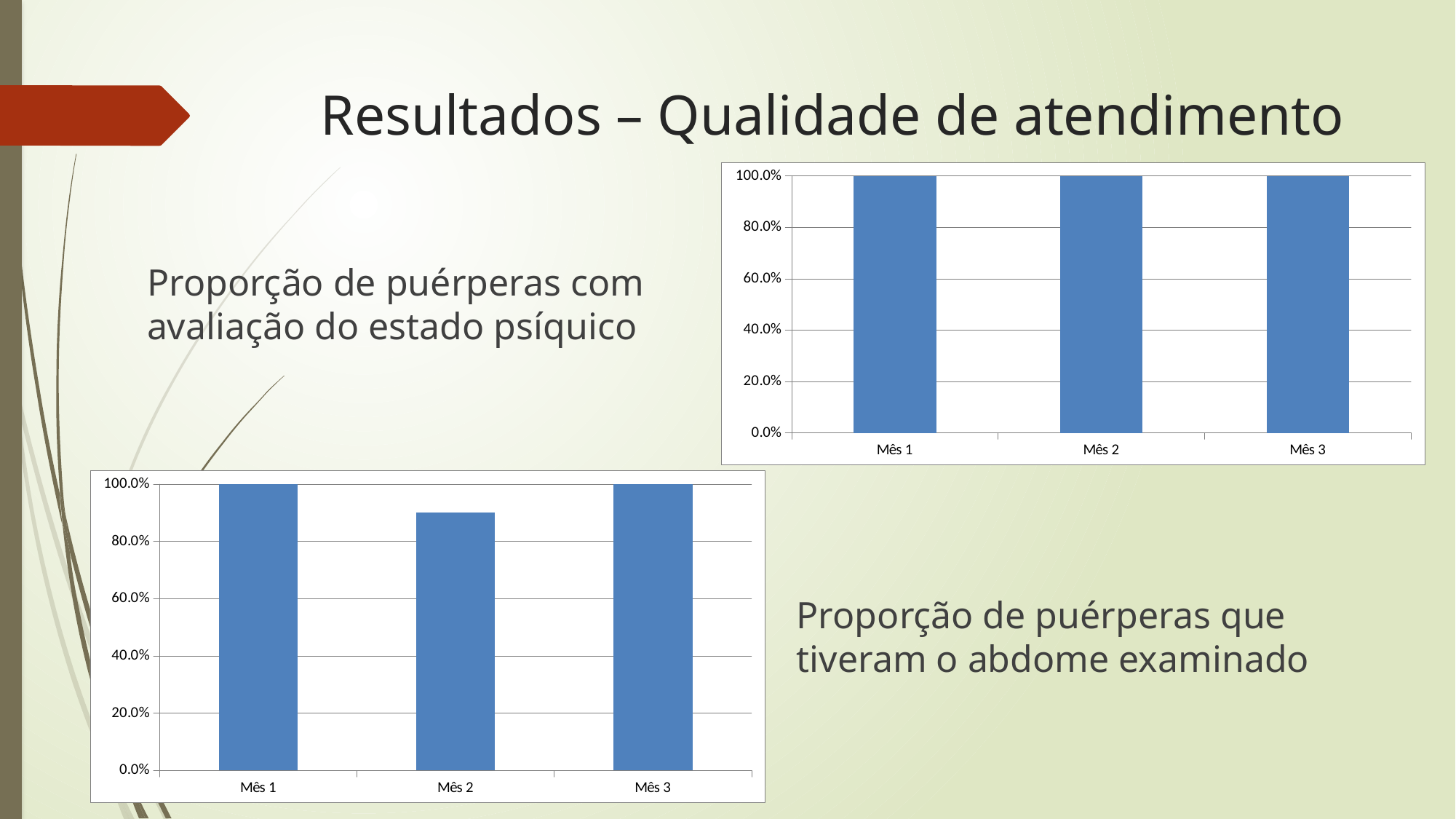
In the top-right chart (avaliação do estado psíquico), what is the value for Mês 3? 100.0% In the bottom-left chart (abdome examinado), what is the value for Mês 1? 100.0% What kind of chart is the bottom-left chart (abdome examinado)? Bar chart In the bottom-left chart (abdome examinado), which month has the lowest value? Mês 2 In the top-right chart (avaliação do estado psíquico), do the values change from Mês 1 to Mês 3? No, they stay at 100.0% In the bottom-left chart (abdome examinado), is the value for Mês 2 greater or less than 80.0%? greater In the top-right chart (avaliação do estado psíquico), what is the value for Mês 1? 100.0% In the bottom-left chart (abdome examinado), what is the value for Mês 3? 100.0% In the bottom-left chart (abdome examinado), is the value for Mês 2 greater or less than 100.0%? less How many months are shown on the x axis of the top-right chart (avaliação do estado psíquico)? 3 What is the title of the slide? Resultados – Qualidade de atendimento In the bottom-left chart (abdome examinado), which is larger, the value for Mês 1 or Mês 2? Mês 1